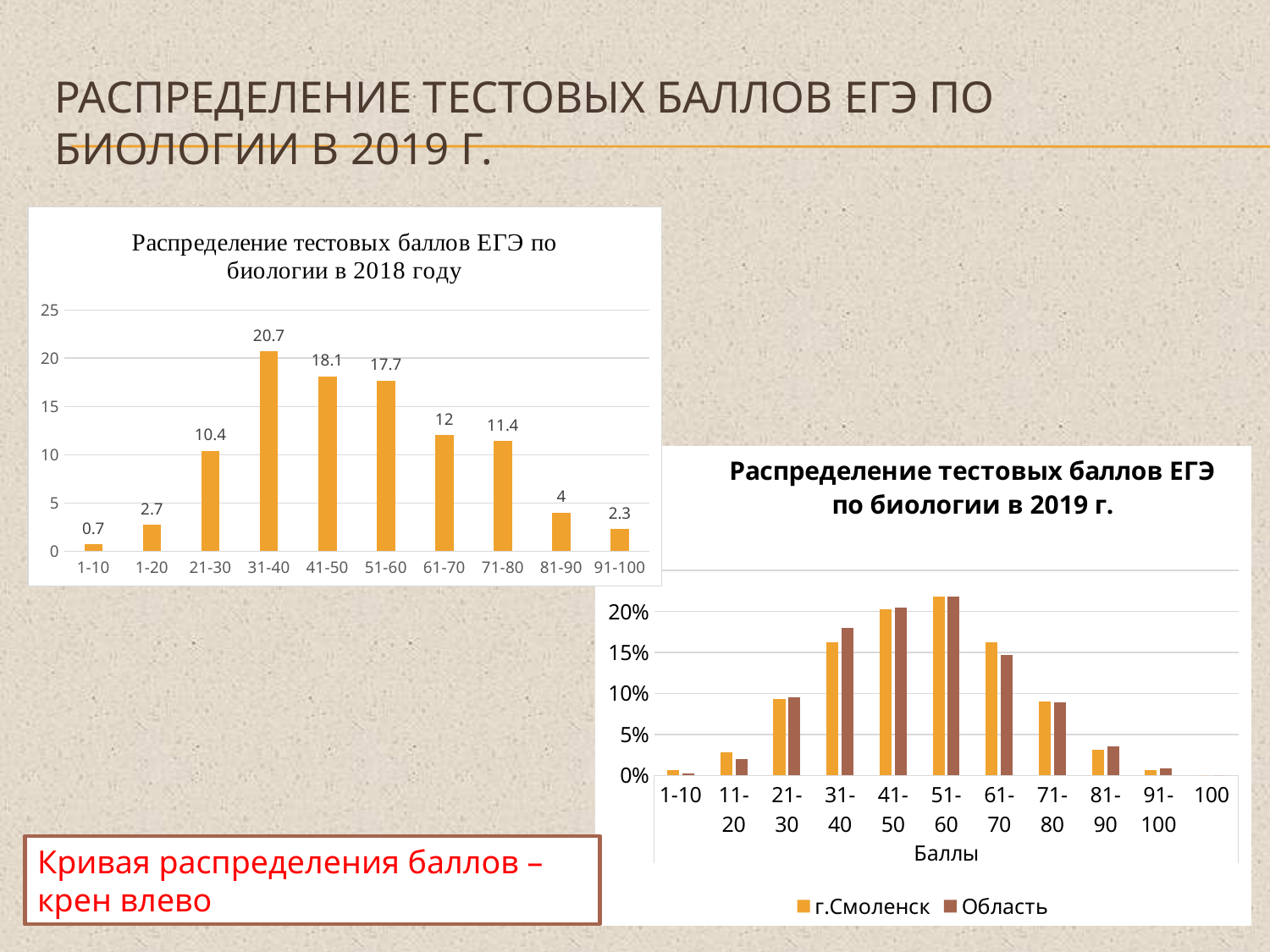
In the chart titled 'Распределение тестовых баллов ЕГЭ по биологии в 2018 году', which category has the lowest value? 1-10 In the chart titled 'Распределение тестовых баллов ЕГЭ по биологии в 2019 г.', is the value for Область in the 71-80 category greater or less than 10%? less In the chart titled 'Распределение тестовых баллов ЕГЭ по биологии в 2018 году', what is the difference between the values for 41-50 and 51-60? 0.4 In the chart titled 'Распределение тестовых баллов ЕГЭ по биологии в 2018 году', which category has the highest value? 31-40 In the chart titled 'Распределение тестовых баллов ЕГЭ по биологии в 2018 году', what is the value for the 91-100 category? 2.3 How many categories are shown on the x axis of the chart titled 'Распределение тестовых баллов ЕГЭ по биологии в 2018 году'? 10 What kind of chart is the chart titled 'Распределение тестовых баллов ЕГЭ по биологии в 2019 г.'? bar chart In the chart titled 'Распределение тестовых баллов ЕГЭ по биологии в 2018 году', what is the value for the 31-40 category? 20.7 How many series does the legend list in the chart titled 'Распределение тестовых баллов ЕГЭ по биологии в 2019 г.'? 2 What are the two series named in the legend of the chart titled 'Распределение тестовых баллов ЕГЭ по биологии в 2019 г.'? г.Смоленск and Область In the chart titled 'Распределение тестовых баллов ЕГЭ по биологии в 2019 г.', is the value for г.Смоленск in the 51-60 category greater or less than 20%? greater In the chart titled 'Распределение тестовых баллов ЕГЭ по биологии в 2018 году', which is larger: the value for 61-70 or for 71-80? 61-70